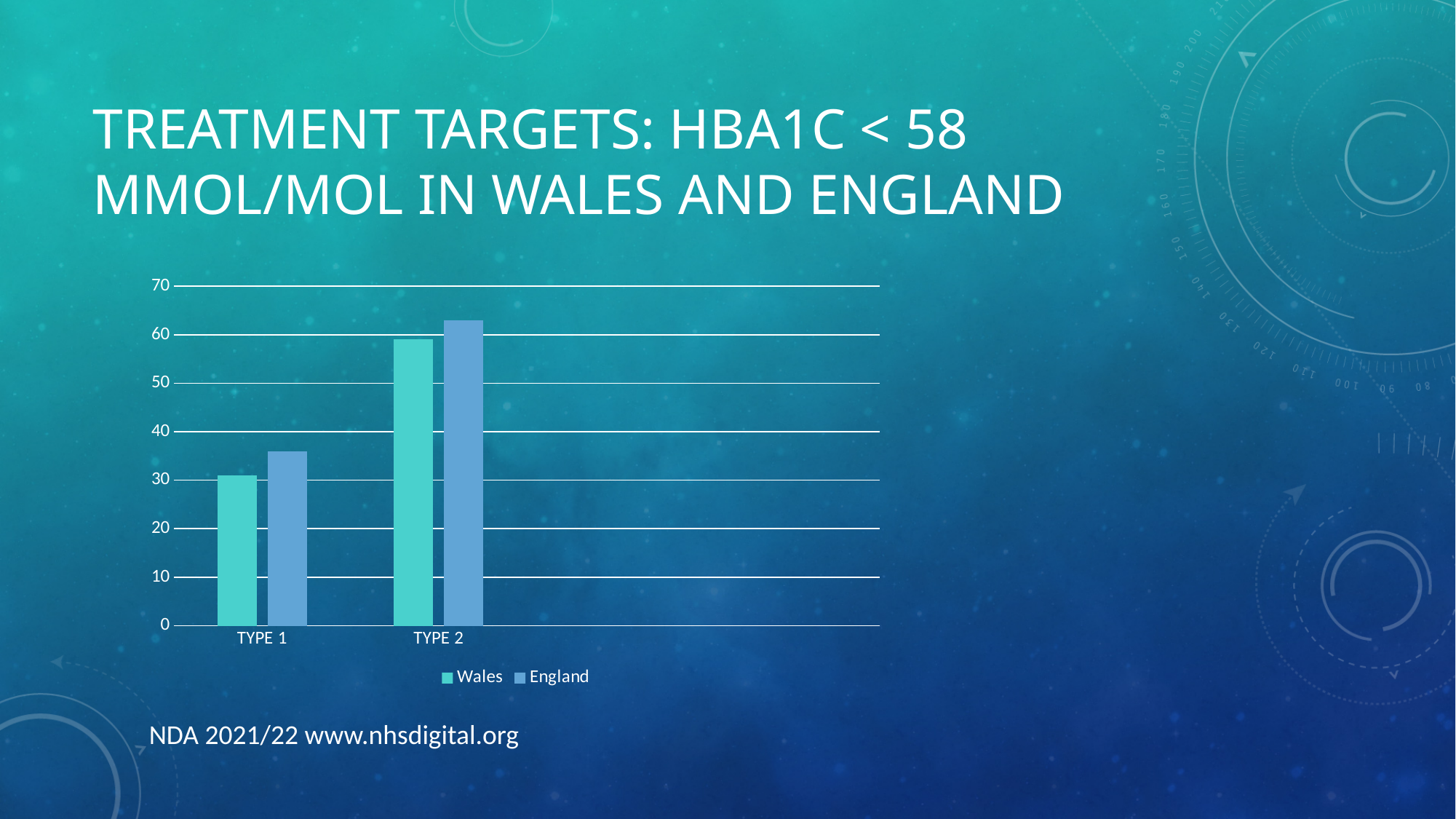
Is the value for Wales in Type 1 greater or less than 40? less Which series does the legend list first? Wales Is the value for England in Type 2 greater or less than 70? less Which is larger for Type 1, Wales or England? England Is the value for England in Type 1 greater or less than 30? greater How many series does the legend list? 2 How many categories are shown on the x axis? 2 Which category has the lowest value for England? Type 1 Which category has the highest value for Wales? Type 2 Which is larger for Type 2, Wales or England? England What kind of chart is shown on the slide? bar chart